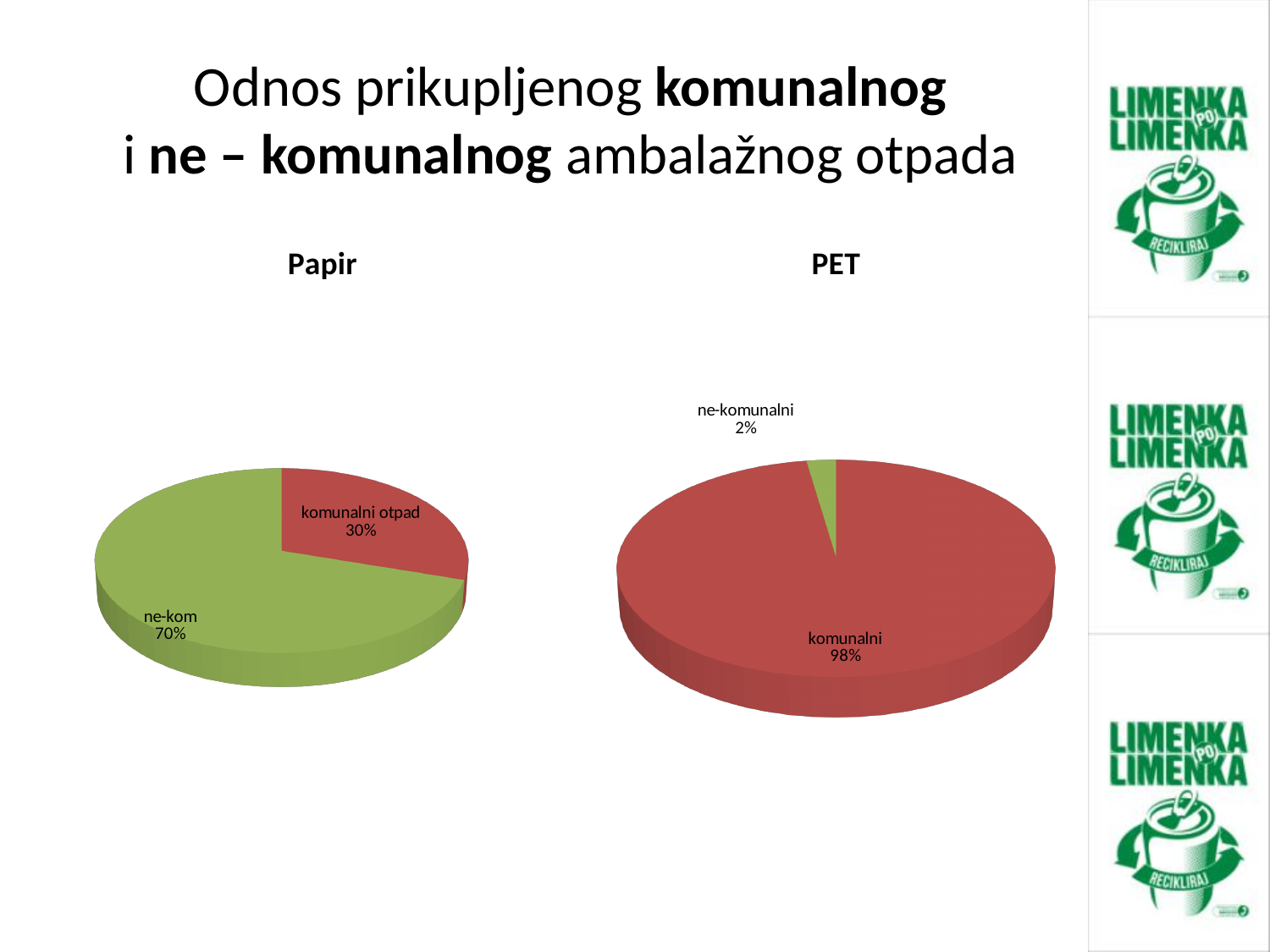
In the Papir chart, what share does 'ne-kom' have? 70% In the PET chart, what share does 'komunalni' have? 98% In the Papir chart, what share does 'komunalni otpad' have? 30% How many slices does the Papir chart have? 2 Which is larger: the 'komunalni otpad' share in the Papir chart or the 'komunalni' share in the PET chart? komunalni in the PET chart In the PET chart, what is the difference between the 'komunalni' and 'ne-komunalni' shares? 96% In the Papir chart, which slice is the largest? ne-kom What colour is the 'ne-kom' slice in the Papir chart? green In the Papir chart, what is the difference between the 'ne-kom' and 'komunalni otpad' shares? 40% What kind of chart is the PET chart? pie chart In the PET chart, which slice is the smallest? ne-komunalni